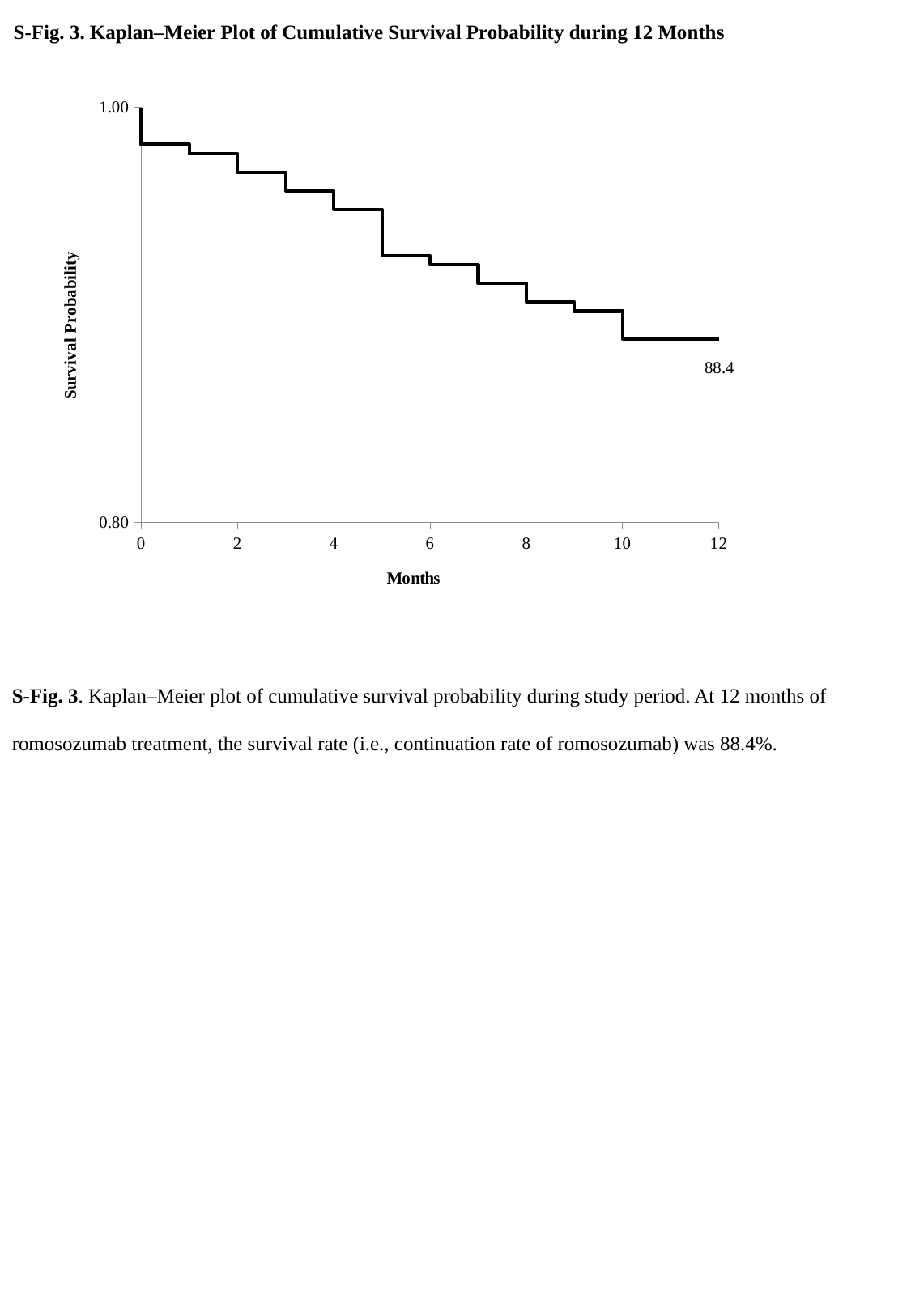
At which month is the survival probability highest? 0 What is the survival probability value labelled at 12 months? 88.4 Is the survival probability at 12 months greater or less than 0.80? greater What kind of chart is shown on the slide? Line chart (Kaplan–Meier step plot) Is the survival probability at 6 months greater or less than 0.80? greater Which is larger, the survival probability at 2 months or at 10 months? 2 months How many tick labels are shown on the x axis? 7 What is the highest value shown on the y axis? 1.00 Does the survival probability rise or fall as months increase along the x axis? Fall What is the label of the x axis? Months